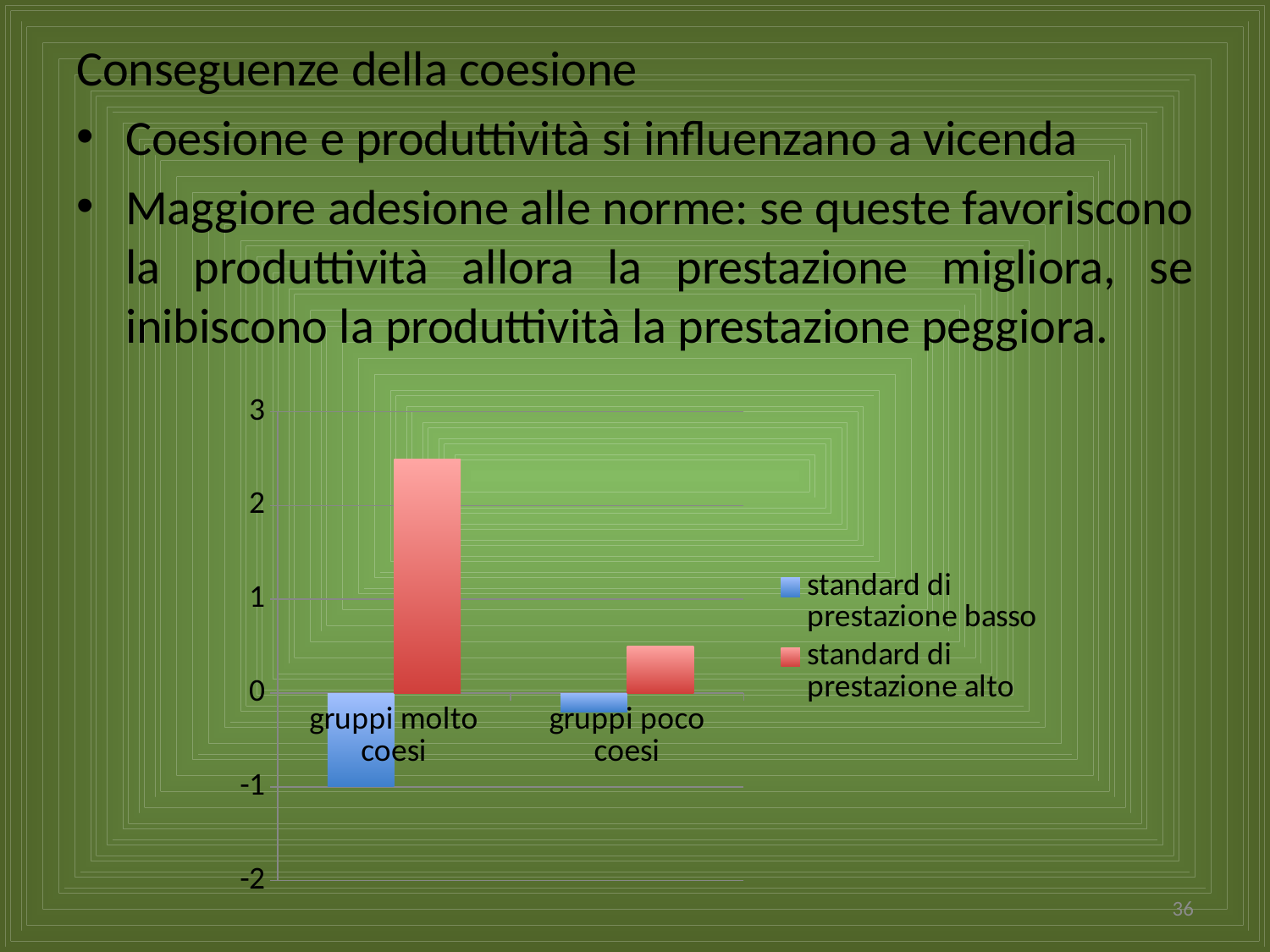
What is the value for 'standard di prestazione basso' in 'gruppi molto coesi'? -1 Is the value for 'standard di prestazione alto' in 'gruppi poco coesi' greater or less than 1? less For 'gruppi molto coesi', which series has the larger value: 'standard di prestazione basso' or 'standard di prestazione alto'? standard di prestazione alto Is the value for 'standard di prestazione basso' in 'gruppi poco coesi' greater or less than 0? less How many categories are shown on the x axis of the chart? 2 What colour represents 'standard di prestazione basso' in the chart? blue Which category has the lowest value for 'standard di prestazione basso'? gruppi molto coesi What kind of chart is shown on the slide? bar chart Do the values for 'standard di prestazione alto' rise or fall from 'gruppi molto coesi' to 'gruppi poco coesi'? fall Which category has the highest value for 'standard di prestazione alto'? gruppi molto coesi How many series does the chart legend list? 2 Is the value for 'standard di prestazione alto' in 'gruppi molto coesi' greater or less than 2? greater